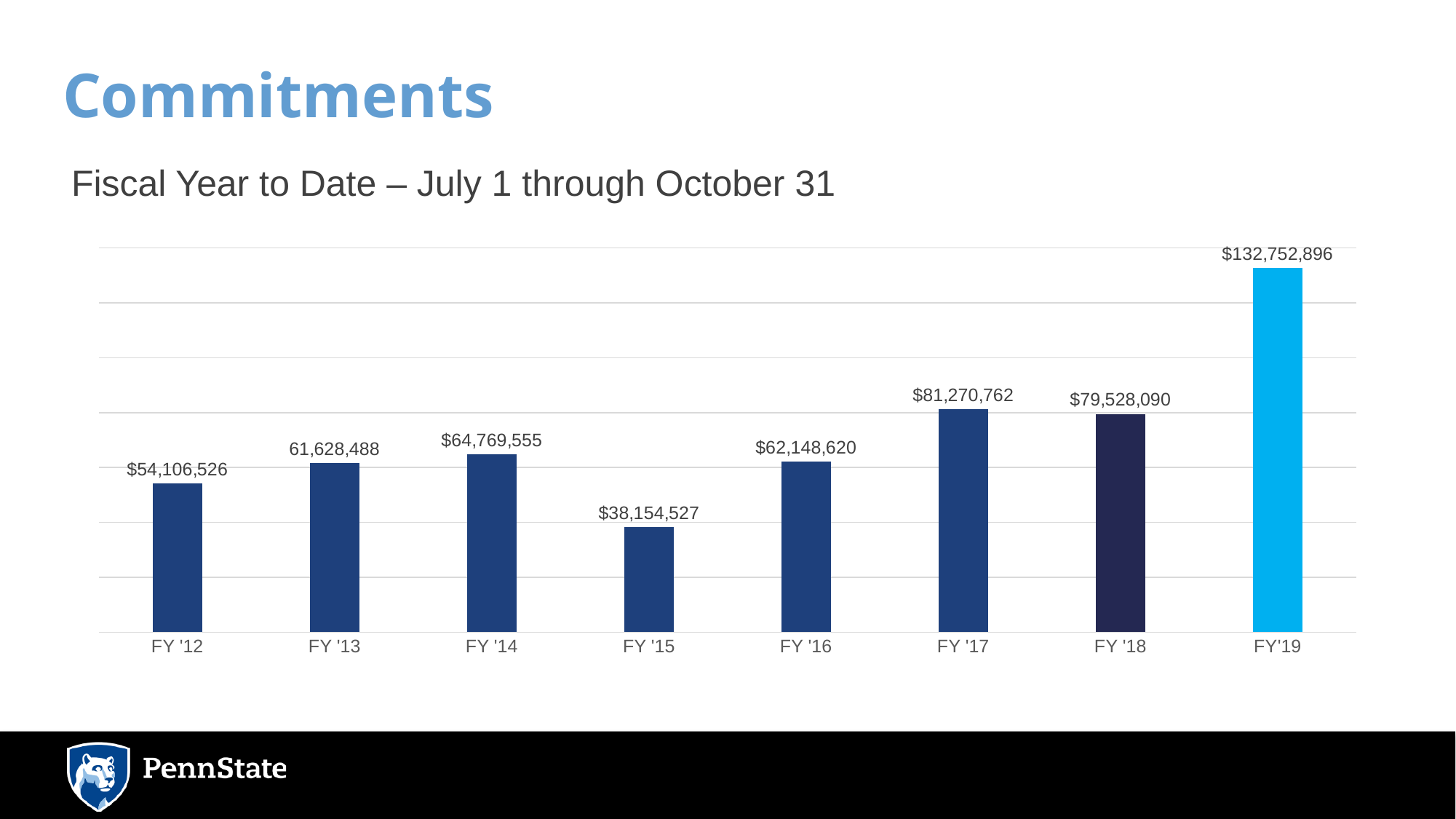
Which fiscal year has the lowest value? FY '15 What kind of chart is shown on the slide? Bar chart What is the value shown for FY '12? $54,106,526 What is the value shown for FY'19? $132,752,896 What is the difference between the FY'19 value and the FY '18 value? $53,224,806 Which is larger, the value for FY '14 or the value for FY '16? FY '14 Which fiscal year has the highest value? FY'19 What is the difference between the FY '16 value and the FY '15 value? $23,994,093 What is the value shown for FY '15? $38,154,527 What is the value shown for FY '13? 61,628,488 Which bar is shown in a lighter blue colour than the others? FY'19 How many fiscal years are shown on the chart? 8